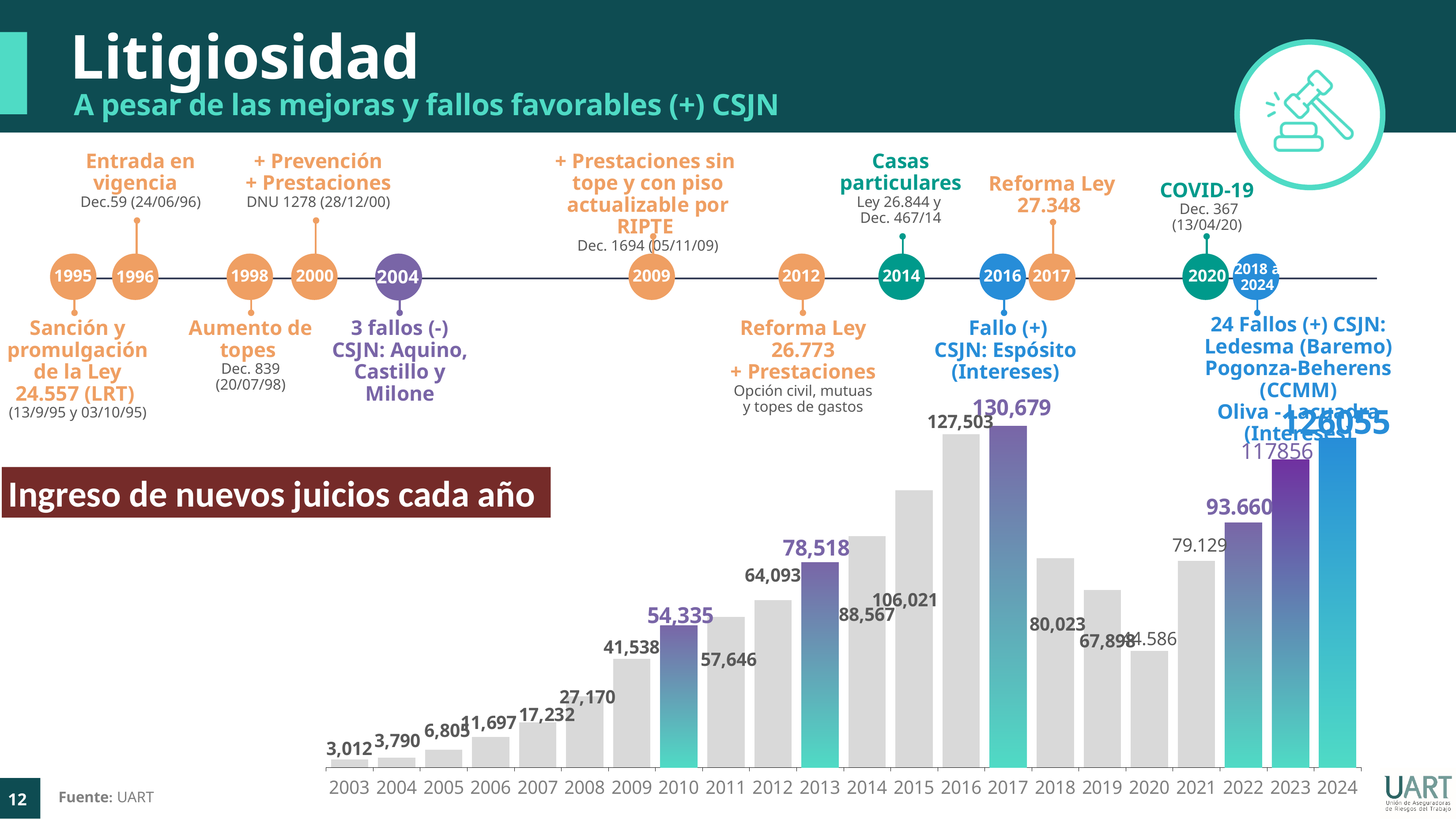
What is the value for 2016 in the 'Ingreso de nuevos juicios cada año' chart? 127,503 How many years are shown on the x axis of the 'Ingreso de nuevos juicios cada año' chart? 22 In the 'Ingreso de nuevos juicios cada año' chart, do the values rise or fall from 2003 to 2017? Rise In the 'Ingreso de nuevos juicios cada año' chart, what is the difference between the values for 2017 and 2016? 3,176 In the 'Ingreso de nuevos juicios cada año' chart, what is the difference between the values for 2016 and 2015? 21,482 Which year has the highest value in the 'Ingreso de nuevos juicios cada año' chart? 2017 What kind of chart is 'Ingreso de nuevos juicios cada año'? Bar chart Which year has the lowest value in the 'Ingreso de nuevos juicios cada año' chart? 2003 What is the value for 2022 in the 'Ingreso de nuevos juicios cada año' chart? 93.660 In the 'Ingreso de nuevos juicios cada año' chart, which is larger, the value for 2015 or the value for 2014? 2015 What is the value for 2017 in the 'Ingreso de nuevos juicios cada año' chart? 130,679 What is the value for 2010 in the 'Ingreso de nuevos juicios cada año' chart? 54,335